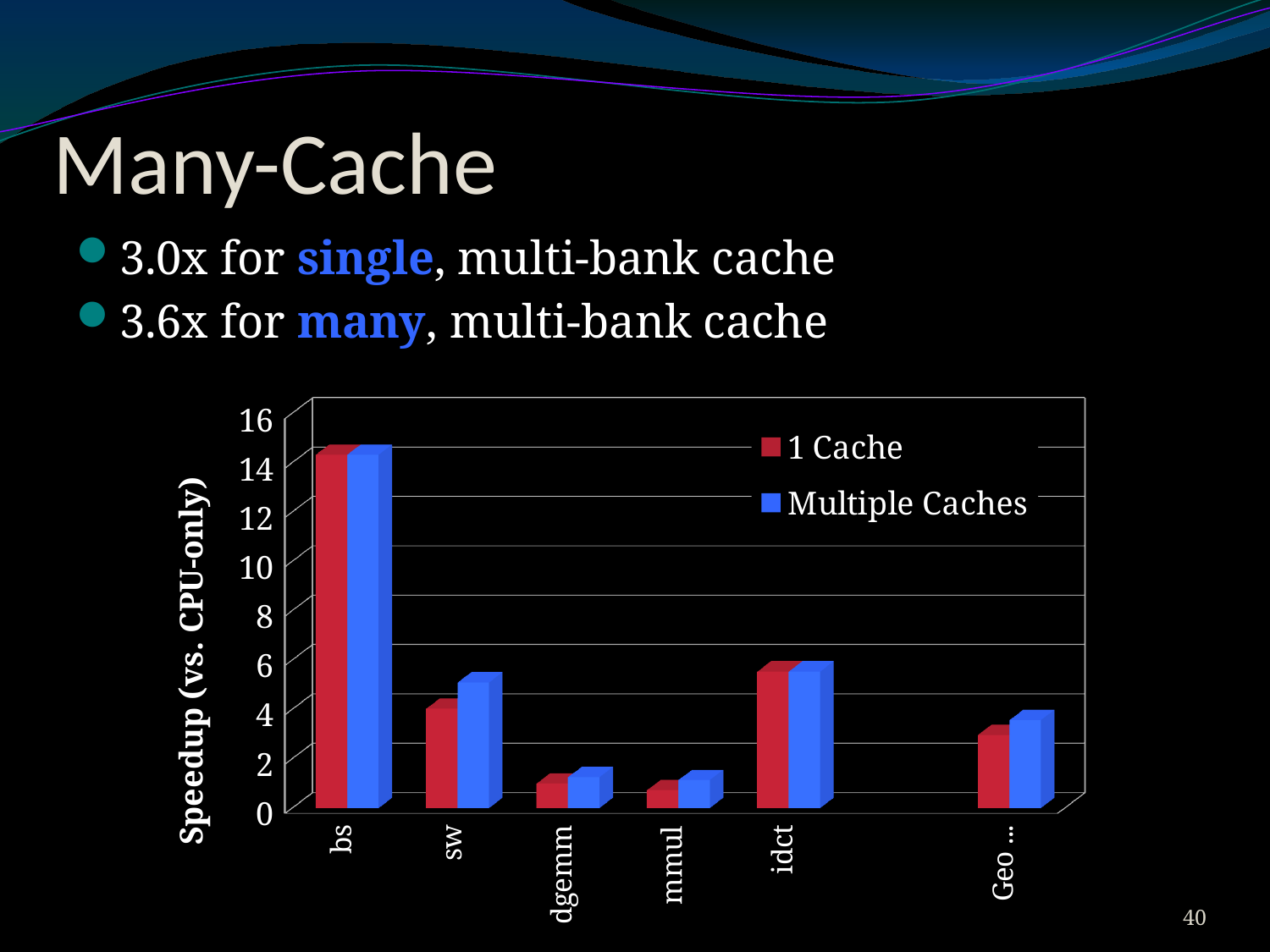
Which category has the highest speedup in the chart? bs How many categories are plotted along the x axis of the chart? 6 Is the 1 Cache value for dgemm greater or less than 2? less Which colour represents the Multiple Caches series in the chart? blue Is the 1 Cache value for mmul greater or less than 2? less Is the Multiple Caches value for idct greater or less than 4? greater How many series does the chart legend list? 2 What is the label of the y axis of the chart? Speedup (vs. CPU-only) For sw, which series has the larger value: 1 Cache or Multiple Caches? Multiple Caches What kind of chart is shown on the slide? bar chart